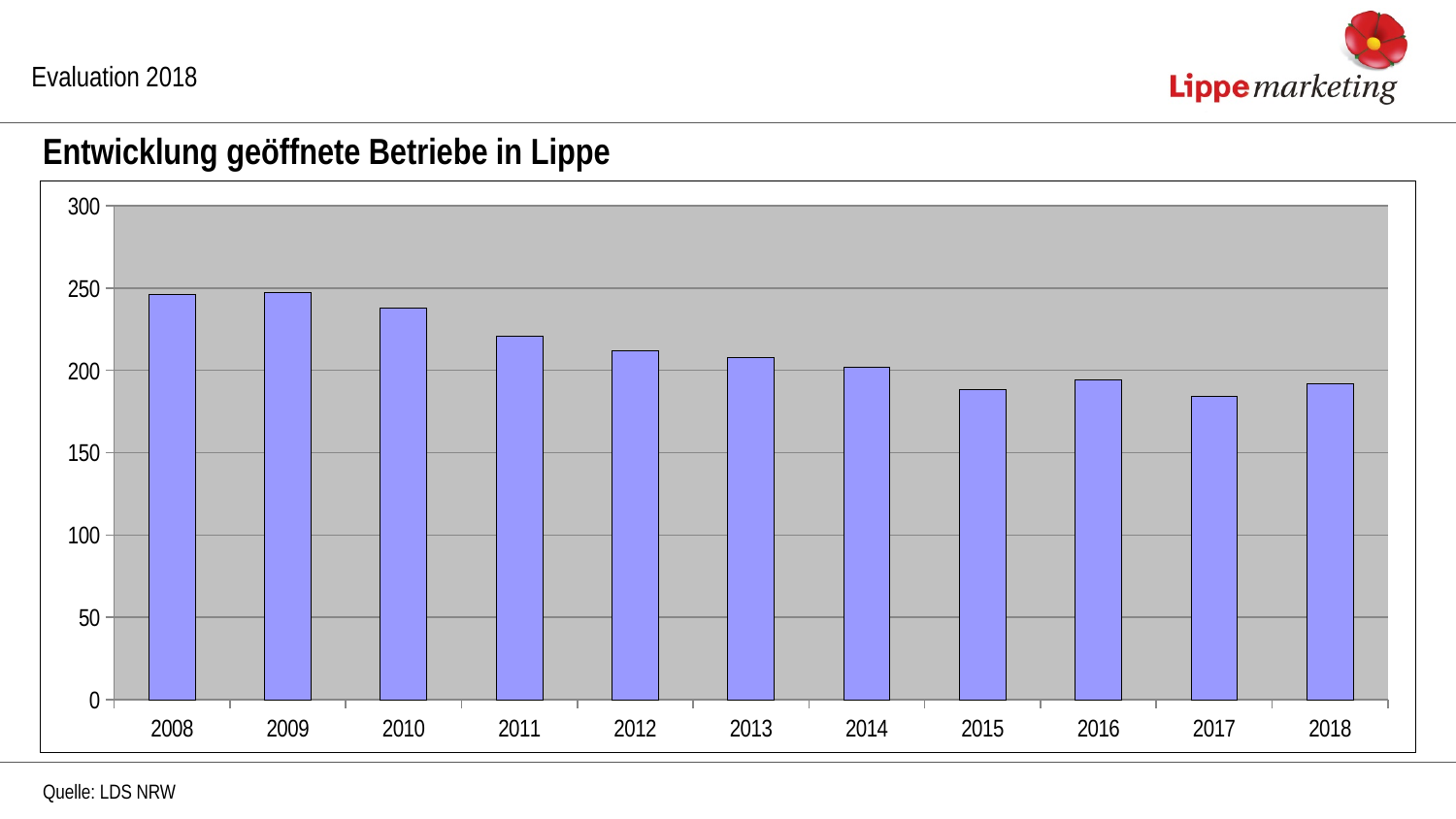
What is the title of the chart? Entwicklung geöffnete Betriebe in Lippe How many years are shown on the x axis of the chart? 11 Is the value for 2016 greater or less than 150? greater Do the values generally rise or fall from 2008 to 2018? fall Is the value for 2017 greater or less than 200? less What kind of chart is shown on the slide? bar chart Is the value for 2010 greater or less than 250? less Which year has the larger value, 2010 or 2011? 2010 Which year has the larger value, 2017 or 2018? 2018